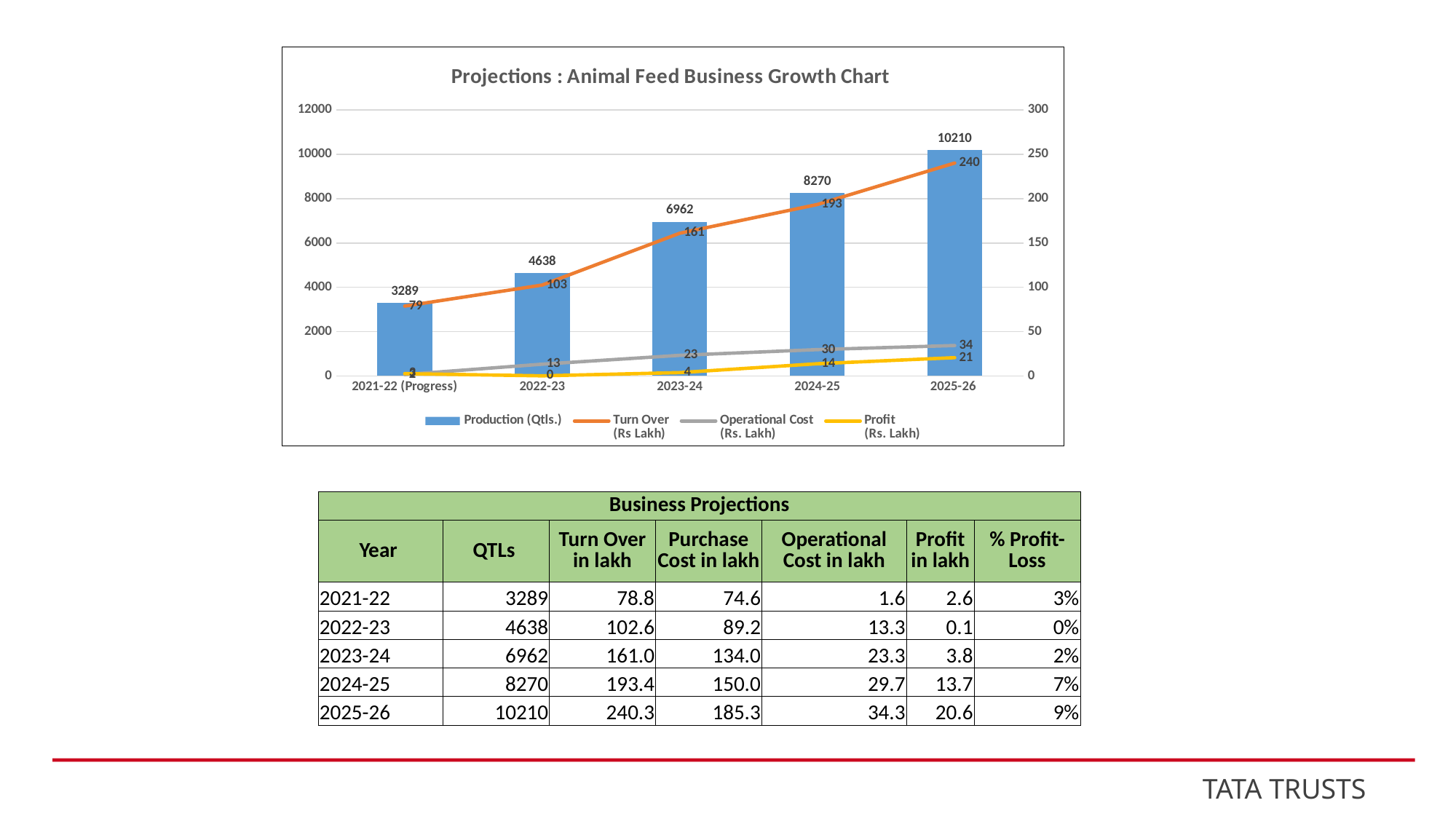
Which year has the lowest Turn Over (Rs Lakh)? 2021-22 (Progress) What is the difference in Production (Qtls.) between 2025-26 and 2024-25? 1940 In 2024-25, which is larger: Turn Over (Rs Lakh) or Operational Cost (Rs. Lakh)? Turn Over (Rs Lakh) How many series does the chart legend list? 4 What is the Operational Cost (Rs. Lakh) value for 2022-23? 13 How many years are shown on the x axis of the chart? 5 Which year has the highest Production (Qtls.)? 2025-26 What kind of chart is shown on the slide? Combination bar and line chart What is the Turn Over (Rs Lakh) value for 2023-24? 161 Does the Turn Over (Rs Lakh) line rise or fall from 2021-22 to 2025-26? Rises What is the Production (Qtls.) value for 2025-26? 10210 What is the Profit (Rs. Lakh) value for 2024-25? 14